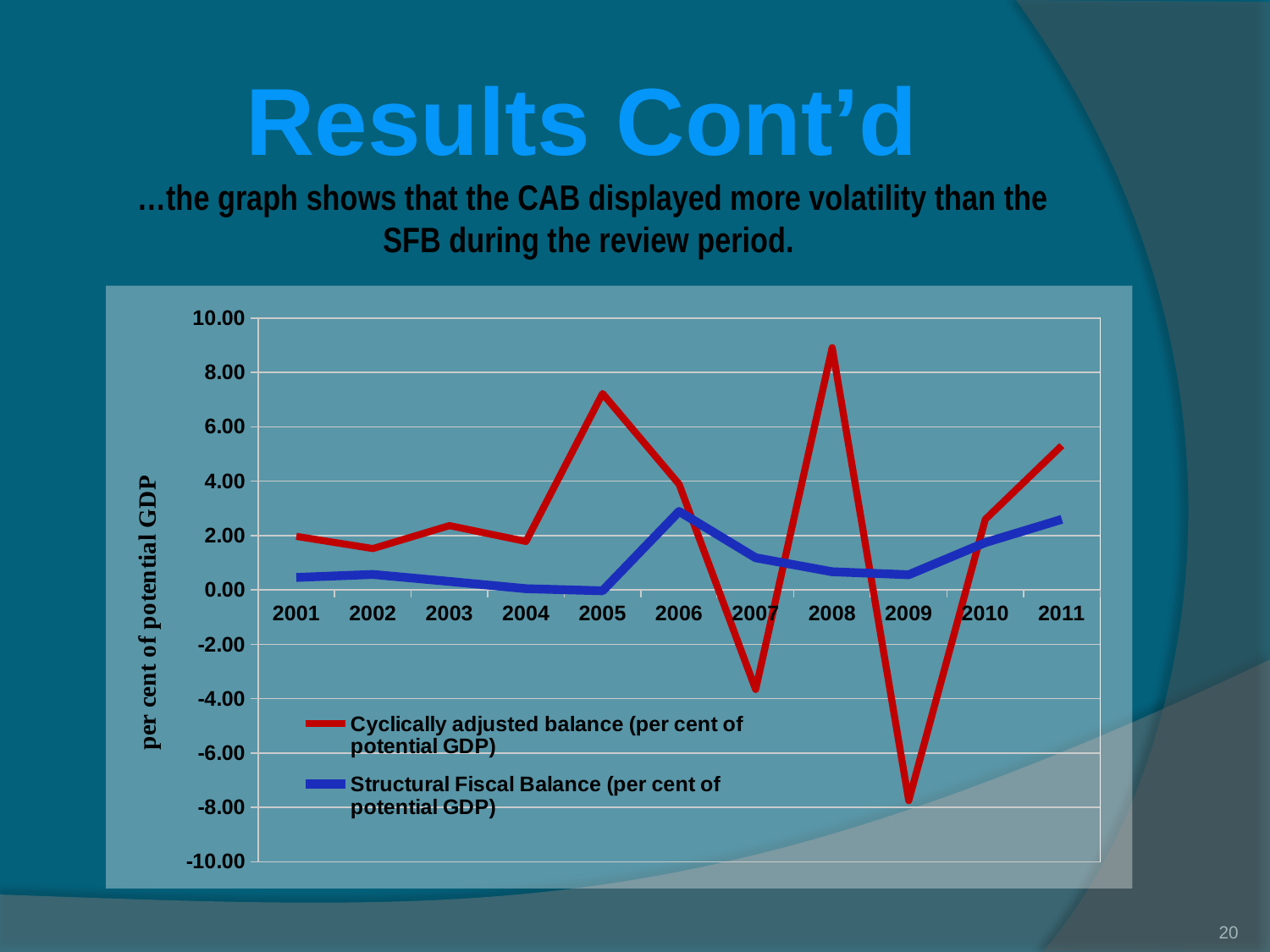
Is the Cyclically adjusted balance in 2008 greater or less than 8.00? greater Is the Cyclically adjusted balance in 2005 greater or less than 6.00? greater How many years are plotted along the x axis? 11 What kind of chart is shown on the slide? line chart In which year does the Cyclically adjusted balance reach its lowest value? 2009 Does the Structural Fiscal Balance rise or fall from 2009 to 2011? rise In which year does the Cyclically adjusted balance reach its highest value? 2008 What is the label on the vertical axis? per cent of potential GDP In 2009, which series has the larger value: the Cyclically adjusted balance or the Structural Fiscal Balance? Structural Fiscal Balance Is the Structural Fiscal Balance in 2006 greater or less than 2.00? greater How many series does the legend list? 2